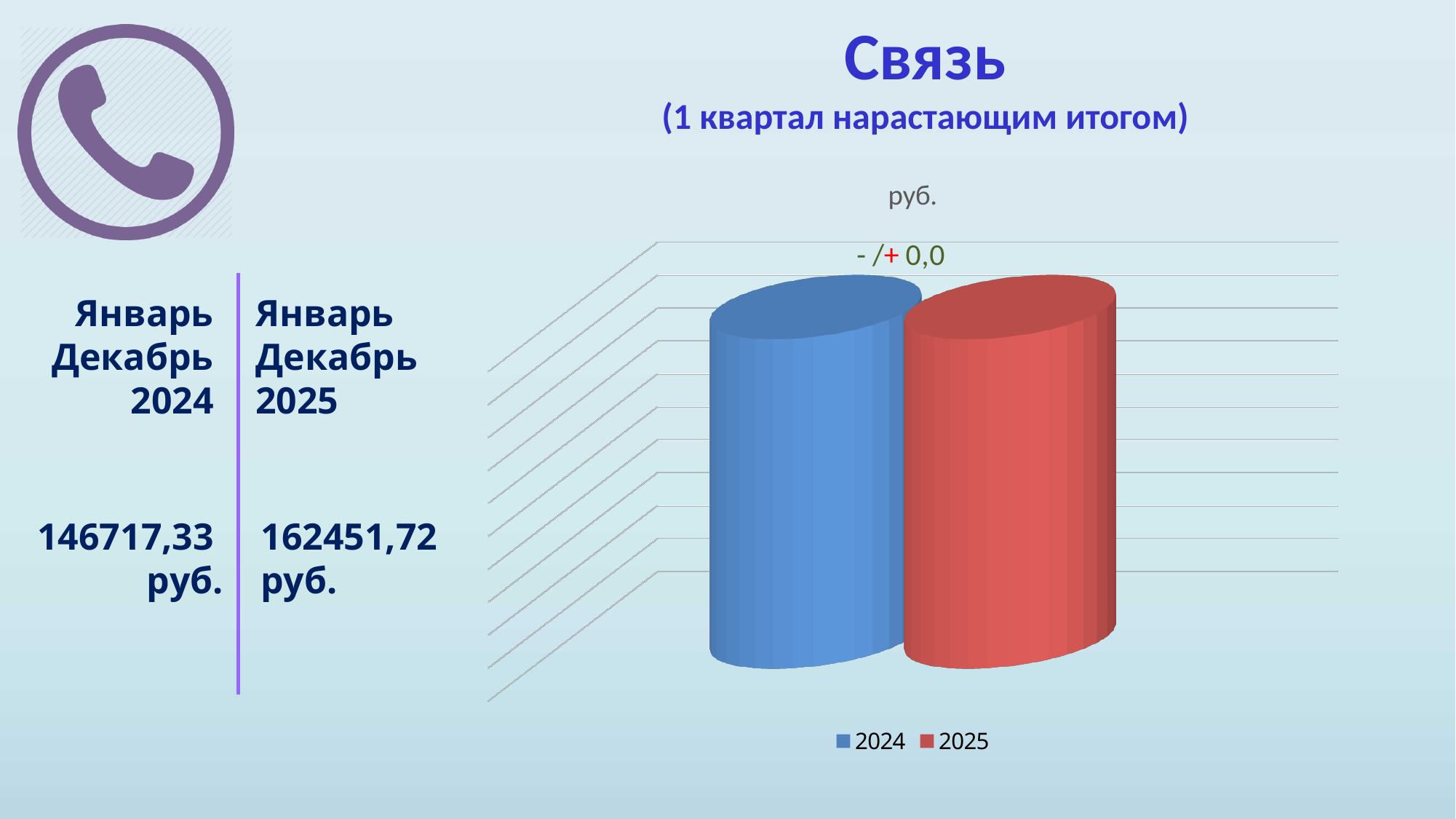
How many series does the chart legend list? 2 Is the value for 2025 larger or smaller than the value for 2024? larger What is the value for 2025 (January–December 2025) shown on the slide? 162451,72 руб. What is the value for 2024 (January–December 2024) shown on the slide? 146717,33 руб. By how much does the 2025 value exceed the 2024 value? 15734,39 руб. Which series has the taller bar in the chart, 2024 or 2025? 2025 What colour is the bar for the 2025 series? red What unit label is shown above the chart? руб. Which series has the shorter bar in the chart, 2024 or 2025? 2024 What kind of chart is shown on the slide? bar chart How many bars are plotted in the chart? 2